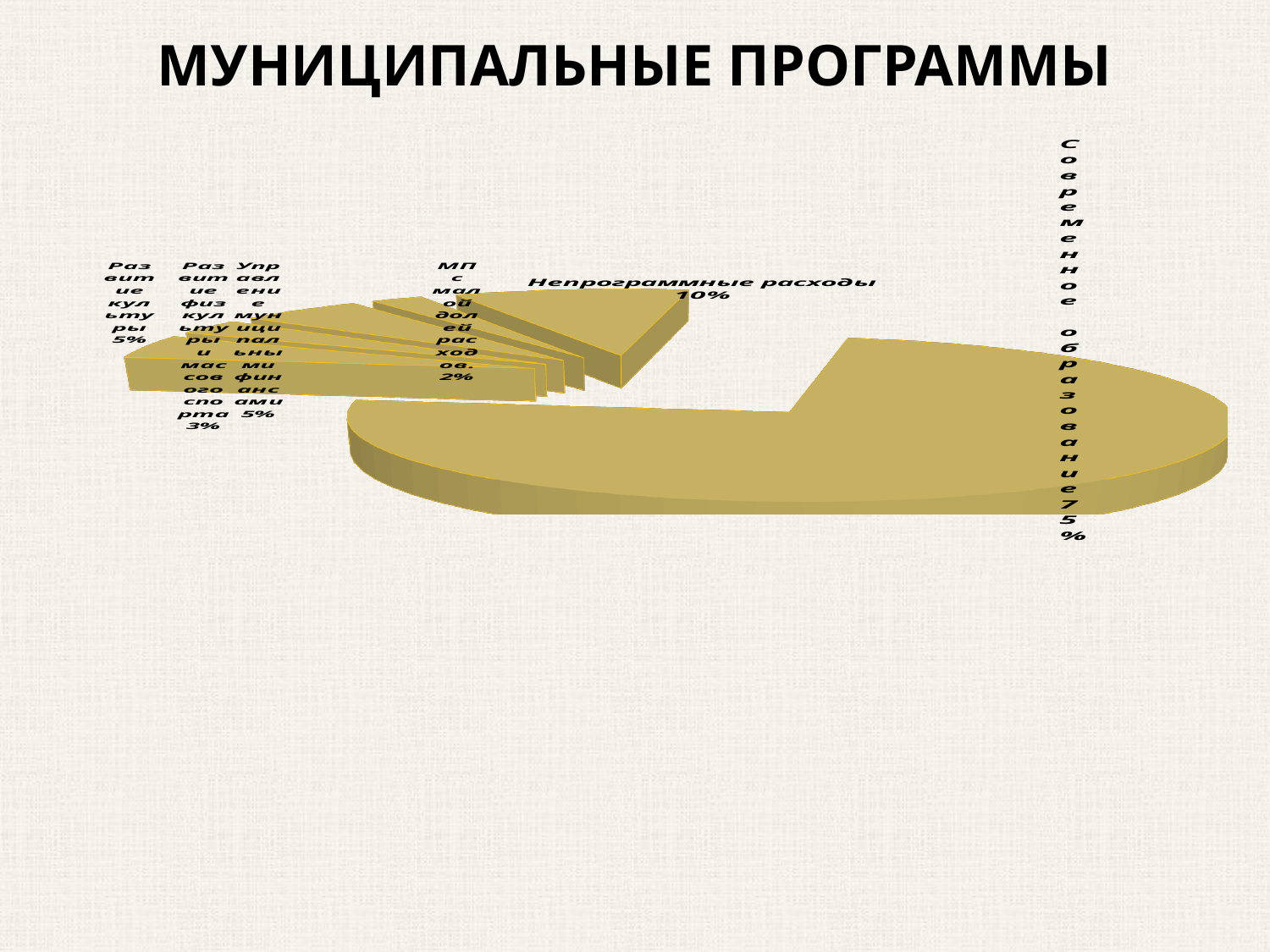
What is the title of the slide? МУНИЦИПАЛЬНЫЕ ПРОГРАММЫ Which slice of the pie is the smallest? МП с малой долей расходов What is the difference between the shares of "Современное образование" and "Непрограммные расходы"? 65% What is the value shown for "МП с малой долей расходов"? 2% How many slices does the pie chart have? 6 What is the value shown for "Управление муниципальными финансами"? 5% What is the value shown for "Непрограммные расходы"? 10% Which slice of the pie is the largest? Современное образование What kind of chart is shown on the slide? pie chart What is the value shown for "Развитие культуры"? 5% What share of the pie does "Современное образование" take? 75% What is the value shown for "Развитие физкультуры и массового спорта"? 3%